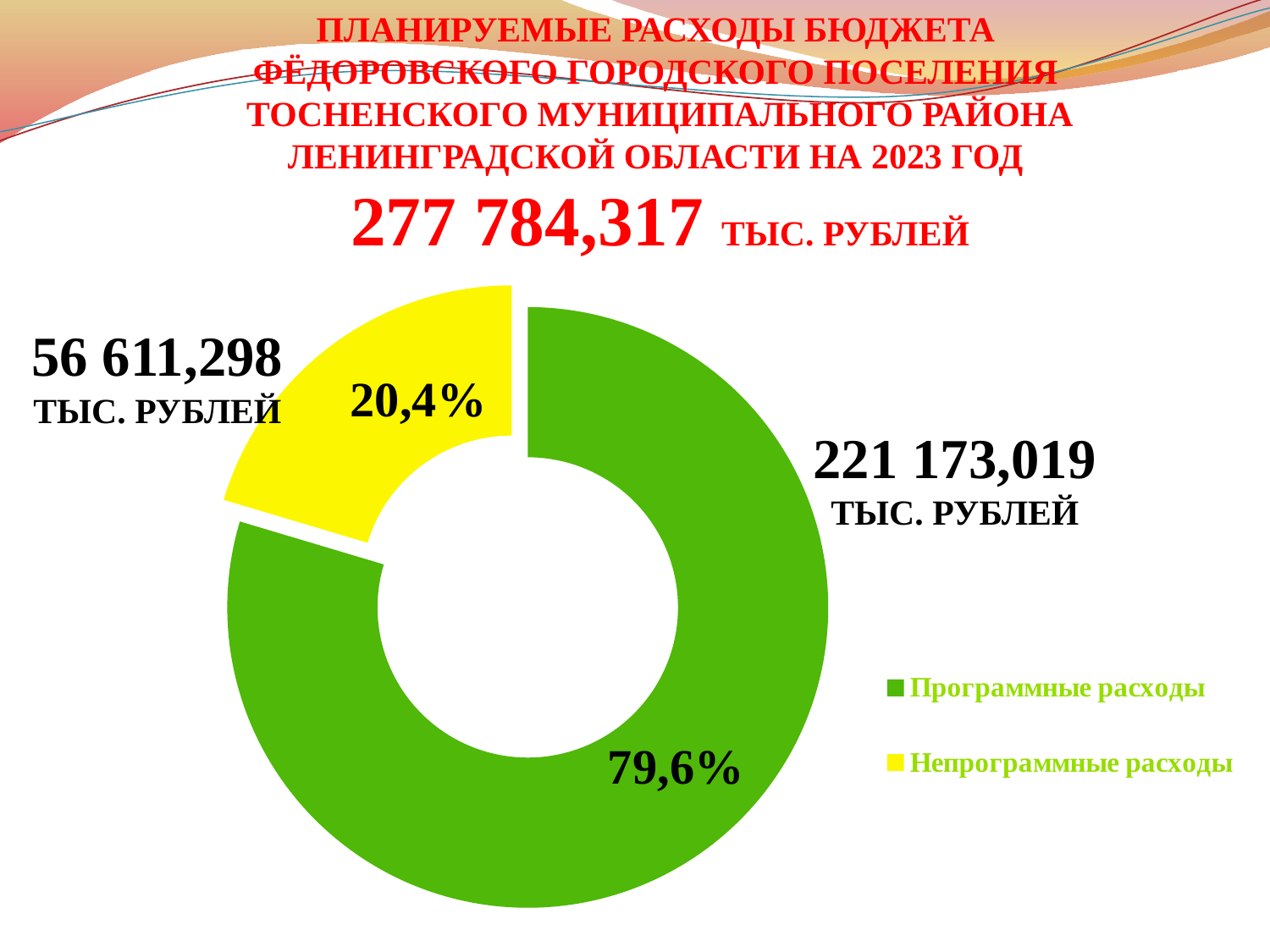
Which is larger, Программные расходы or Непрограммные расходы? Программные расходы What is the difference between the values for Программные расходы and Непрограммные расходы? 164 561,721 тыс. рублей What is the value shown for Непрограммные расходы? 56 611,298 тыс. рублей What share of the pie does Непрограммные расходы take? 20,4% Which category has the largest slice of the pie? Программные расходы How many categories does the pie chart show? 2 What is the difference in percentage points between the Программные расходы and Непрограммные расходы slices? 59,2% Which category has the smallest slice of the pie? Непрограммные расходы What is the value shown for Программные расходы? 221 173,019 тыс. рублей What share of the pie does Программные расходы take? 79,6% What is the total of the two categories shown on the slide? 277 784,317 тыс. рублей What colour is the slice for Непрограммные расходы? Yellow